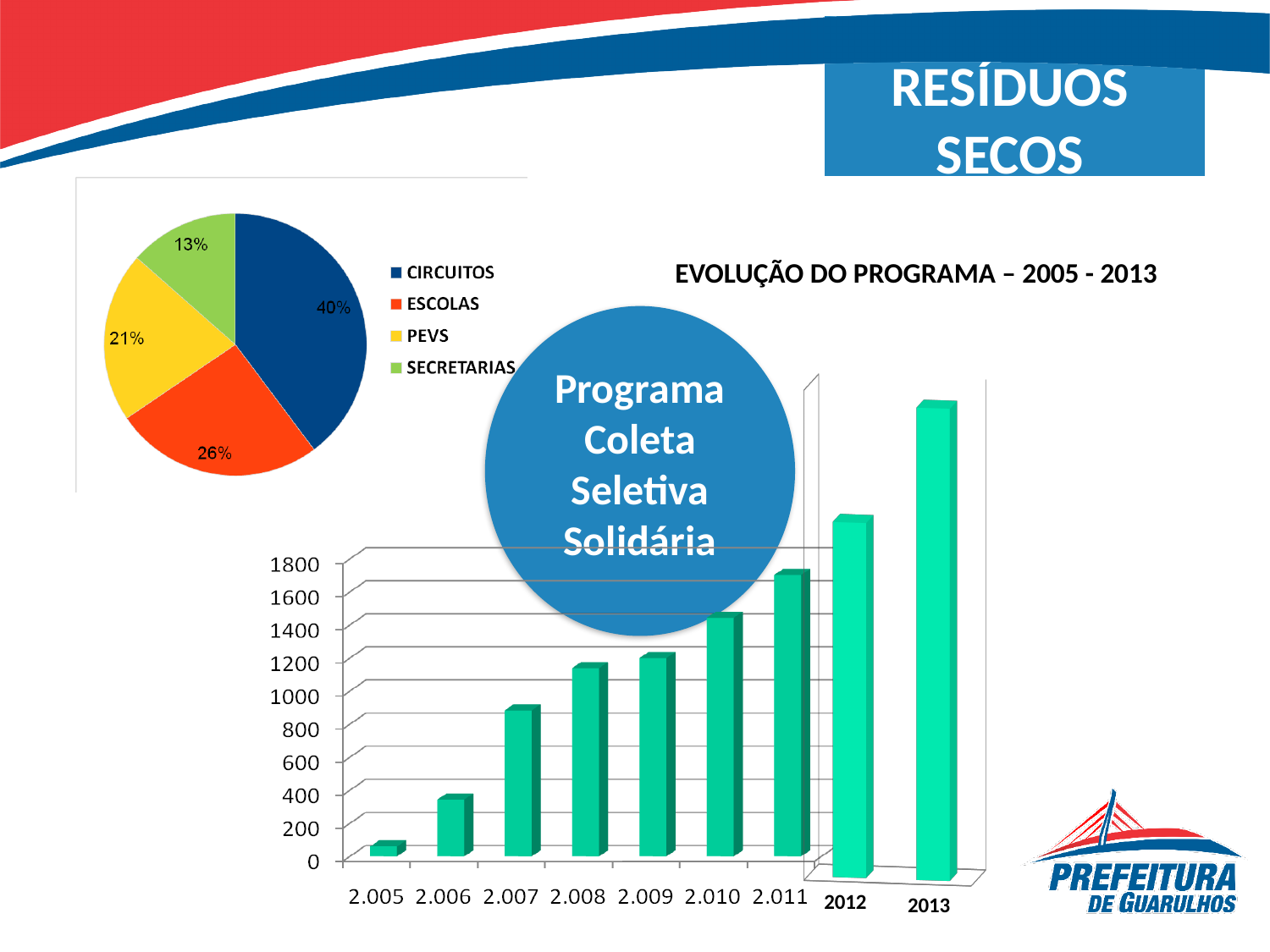
In the 'EVOLUÇÃO DO PROGRAMA – 2005 - 2013' chart, is the value for 2005 greater or less than 200? less In the pie chart, what is the difference between the ESCOLAS share and the SECRETARIAS share? 13% In the pie chart, which category has the smallest share? SECRETARIAS In the 'EVOLUÇÃO DO PROGRAMA – 2005 - 2013' chart, how many years are shown on the x axis? 9 In the 'EVOLUÇÃO DO PROGRAMA – 2005 - 2013' chart, is the value for 2009 greater or less than 1000? greater In the 'EVOLUÇÃO DO PROGRAMA – 2005 - 2013' chart, do the values rise or fall from 2005 to 2013? rise In the pie chart, which category has the largest share? CIRCUITOS How many categories does the pie chart's legend list? 4 In the pie chart, which is larger, ESCOLAS or PEVS? ESCOLAS What type of chart is the 'EVOLUÇÃO DO PROGRAMA – 2005 - 2013' chart? bar chart In the pie chart, what percentage is shown for PEVS? 21% In the pie chart, what percentage is shown for CIRCUITOS? 40%